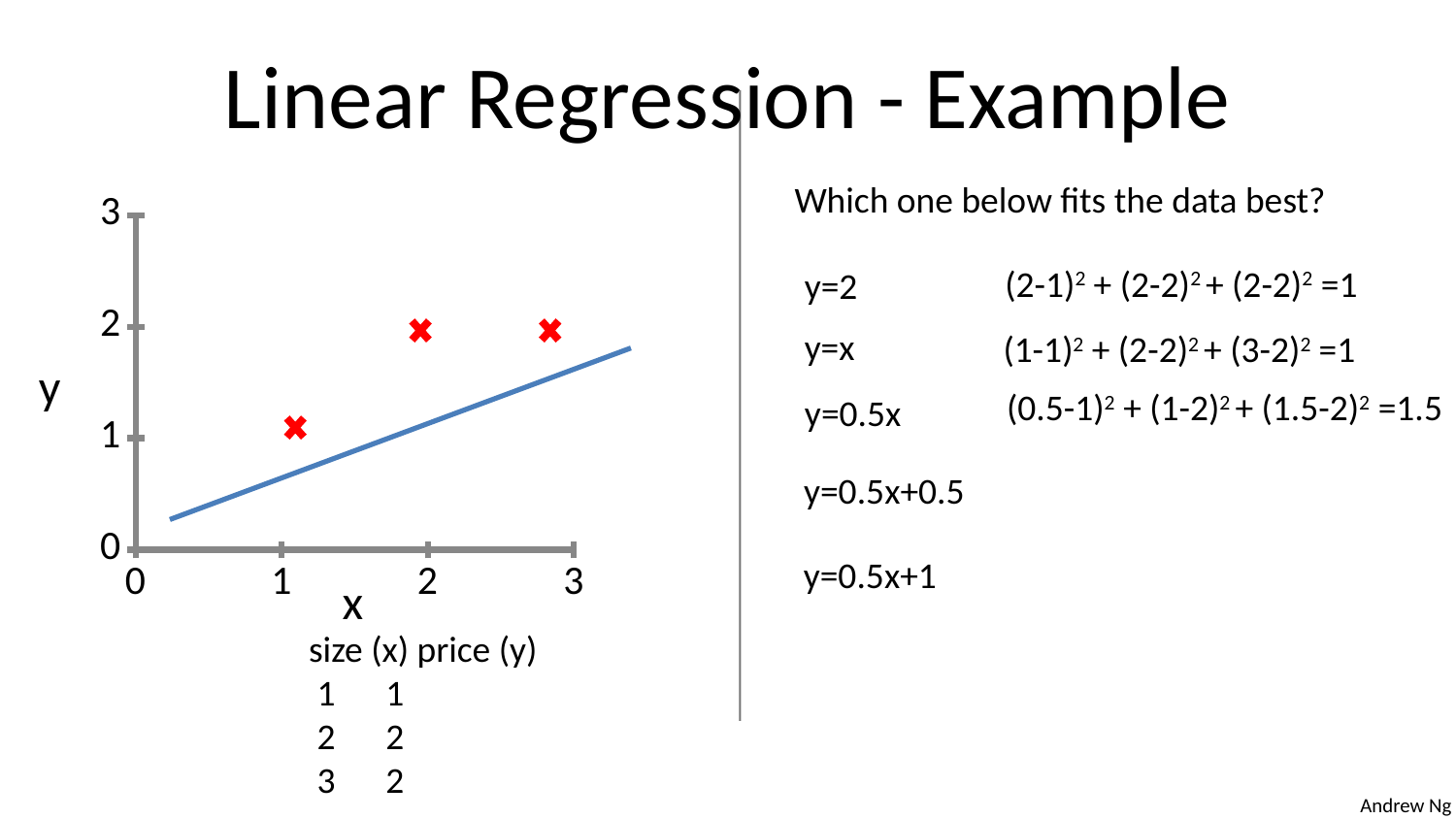
What is the price (y) value for size (x) = 2? 2 Which size (x) value has the lowest price (y)? 1 What is the highest tick value shown on the x axis? 3 What kind of chart is shown on the slide? scatter chart Do the plotted y values rise or fall from x = 1 to x = 2? rise What is the difference in price (y) between size (x) = 2 and size (x) = 1? 1 How many data points (red X markers) are plotted on the chart? 3 What is the price (y) value for size (x) = 3? 2 What is the label on the vertical axis of the chart? y Which has the larger price (y): size (x) = 1 or size (x) = 2? size (x) = 2 Is the y value of the point at x = 3 greater or less than 1? greater What is the price (y) value for size (x) = 1? 1